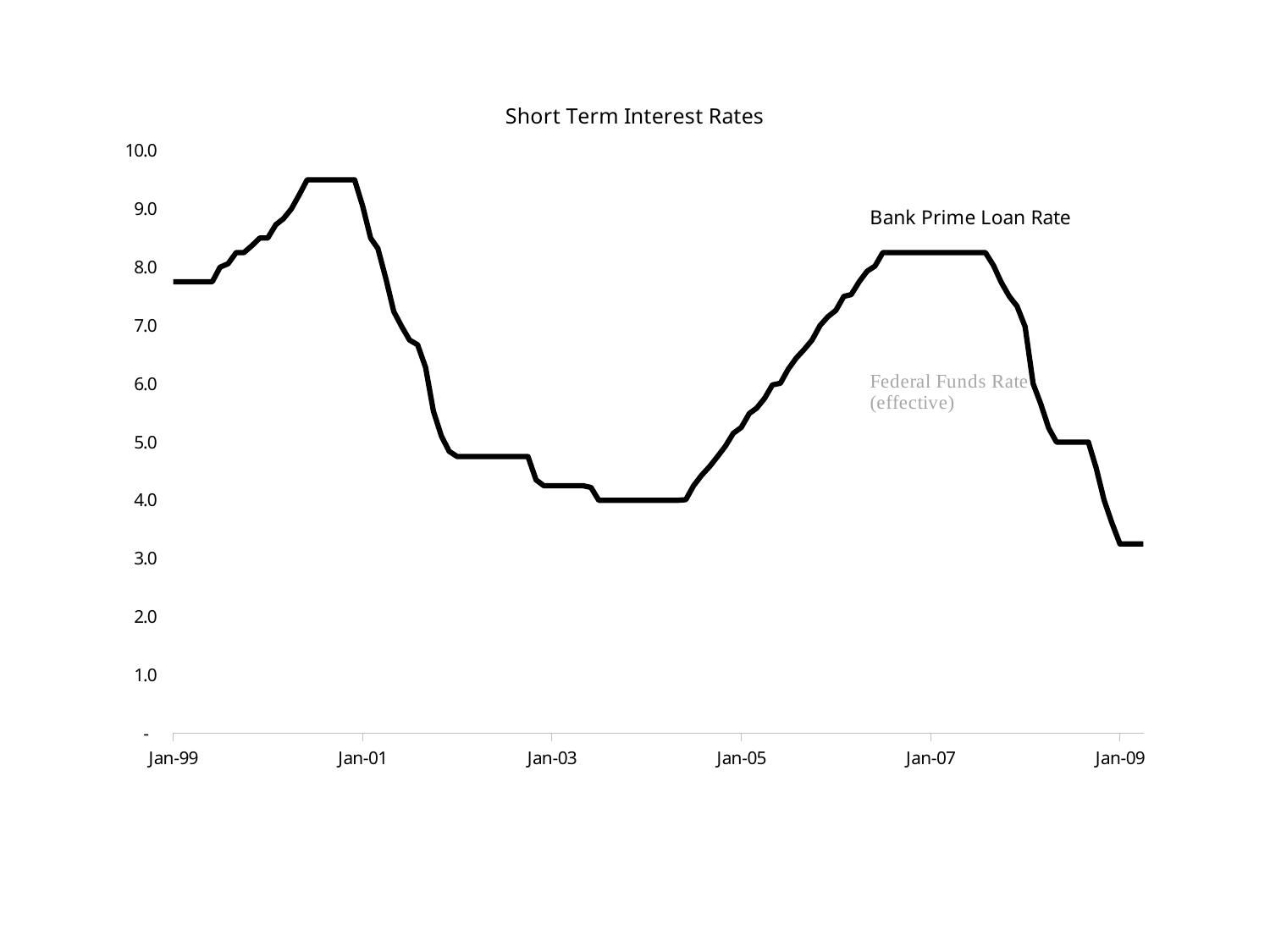
Does the line rise or fall between Jan-01 and Jan-03? fall Is the value of the line at Jan-09 greater or less than 4.0? less What kind of chart is shown on the slide? line chart Is the value of the line at Jan-03 greater or less than 4.0? greater Does the line rise or fall between Jan-05 and Jan-07? rise Is the value of the line at Jan-99 greater or less than 8.0? less How many date labels are shown on the x axis? 6 Does the line rise or fall between Jan-07 and Jan-09? fall What is the title of the chart? Short Term Interest Rates Which series label is printed in black next to the plotted line? Bank Prime Loan Rate